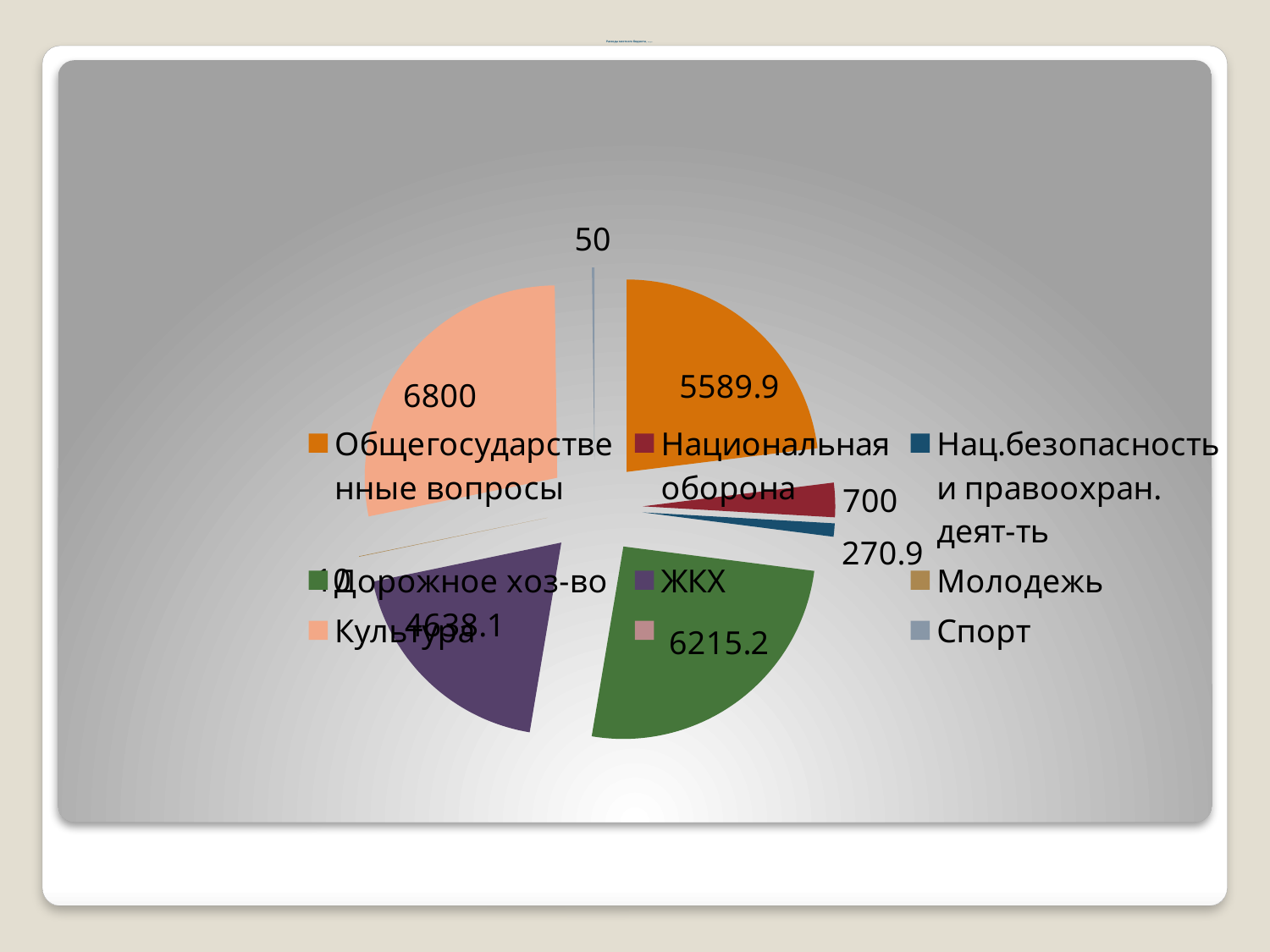
What is the difference between the values for Культура and Дорожное хоз-во? 584.8 What is the value shown for Культура? 6800 What is the value shown for Общегосударственные вопросы? 5589.9 What is the value shown for Нац.безопасность и правоохран. деят-ть? 270.9 What kind of chart is shown on the slide? pie chart What is the value shown for Национальная оборона? 700 What is the value shown for ЖКХ? 4638.1 Which is larger, Общегосударственные вопросы or Дорожное хоз-во? Дорожное хоз-во Which category has the largest slice of the pie? Культура What is the value shown for Дорожное хоз-во? 6215.2 What is the difference between the values for Национальная оборона and Нац.безопасность и правоохран. деят-ть? 429.1 What colour is the slice for ЖКХ? purple